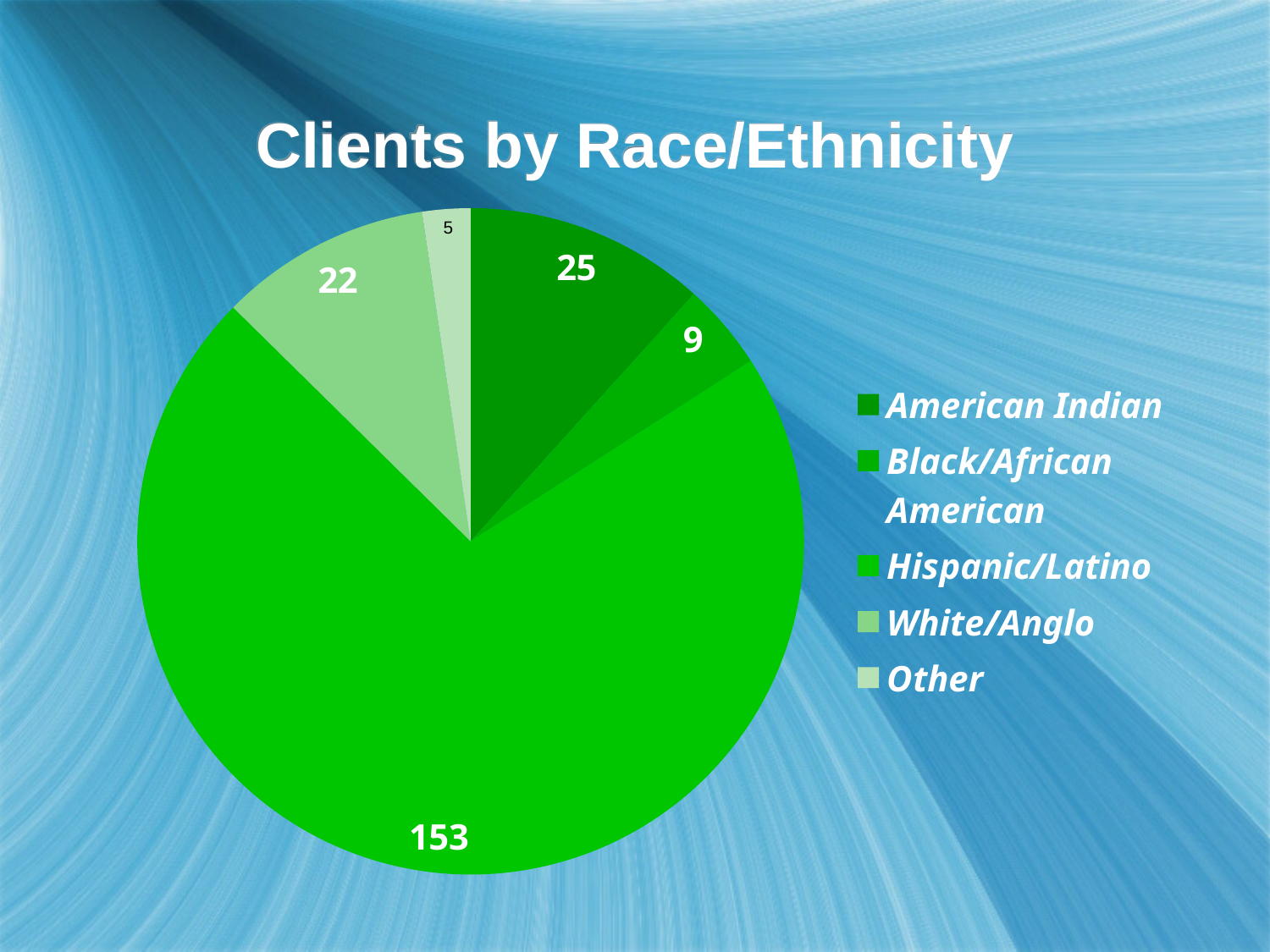
Which category has the largest slice of the pie chart? Hispanic/Latino What is the value for White/Anglo in the pie chart? 22 Which category has the smallest slice of the pie chart? Other What is the difference between the Hispanic/Latino value and the American Indian value? 128 What is the value for Hispanic/Latino in the pie chart? 153 What is the value for Other in the pie chart? 5 What is the title of the chart? Clients by Race/Ethnicity Which is larger, the value for American Indian or the value for White/Anglo? American Indian What is the value for Black/African American in the pie chart? 9 What type of chart is shown on the slide? Pie chart How many categories are shown in the pie chart? 5 What is the value for American Indian in the pie chart? 25